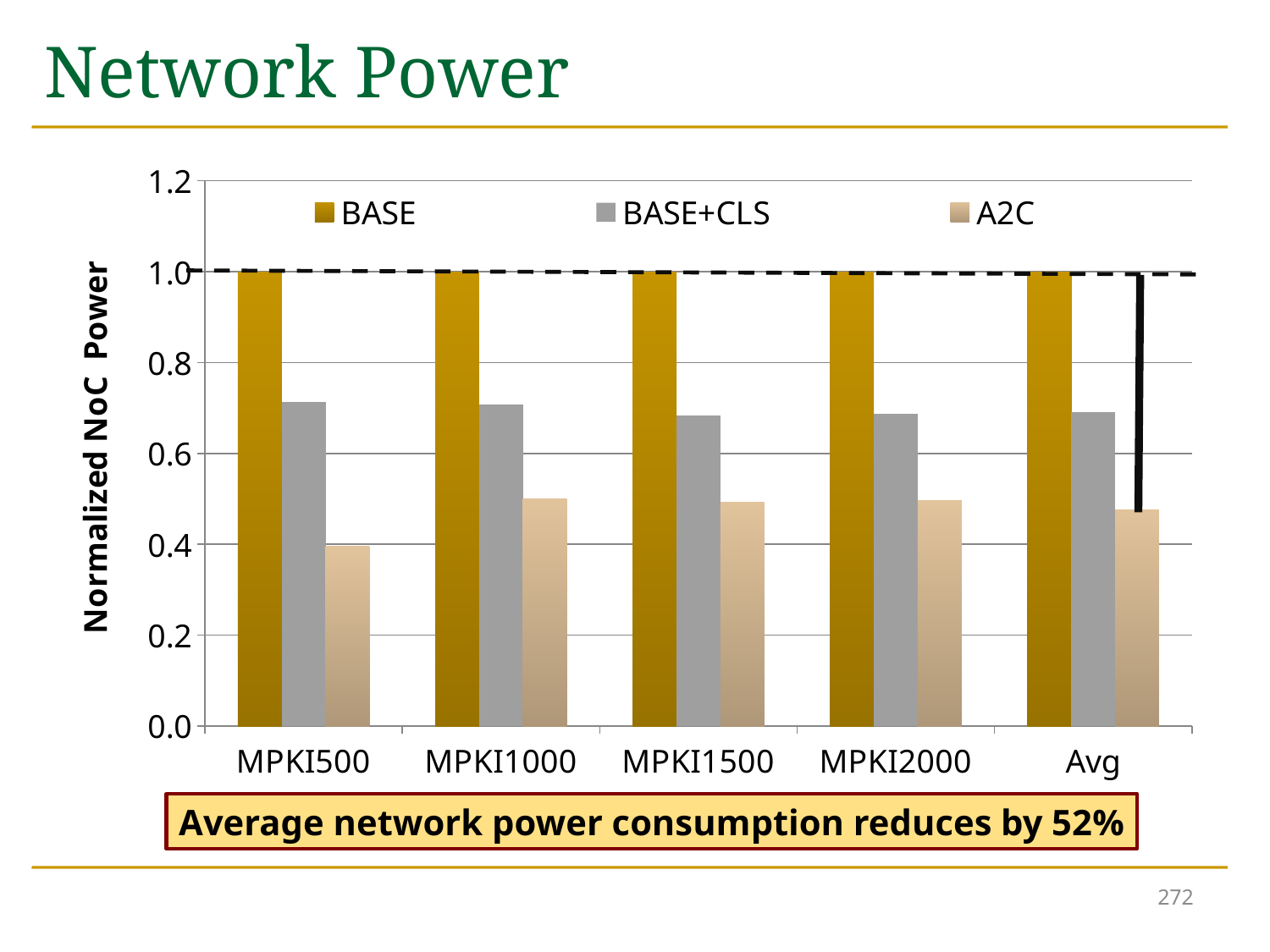
How many categories are shown on the x axis? 5 What is the value of BASE for Avg? 1.0 What is the value of BASE for MPKI500? 1.0 Which category has the lowest A2C value? MPKI500 Is the value of A2C for Avg greater or less than 0.6? less For MPKI1500, which is larger: BASE+CLS or A2C? BASE+CLS By what percentage does the slide say average network power consumption reduces? 52% Is the value of A2C for MPKI500 greater or less than 0.6? less How many series does the legend list? 3 Is the value of BASE+CLS for MPKI500 greater or less than 0.6? greater What kind of chart is shown on the slide? bar chart What is the label of the y axis? Normalized NoC Power